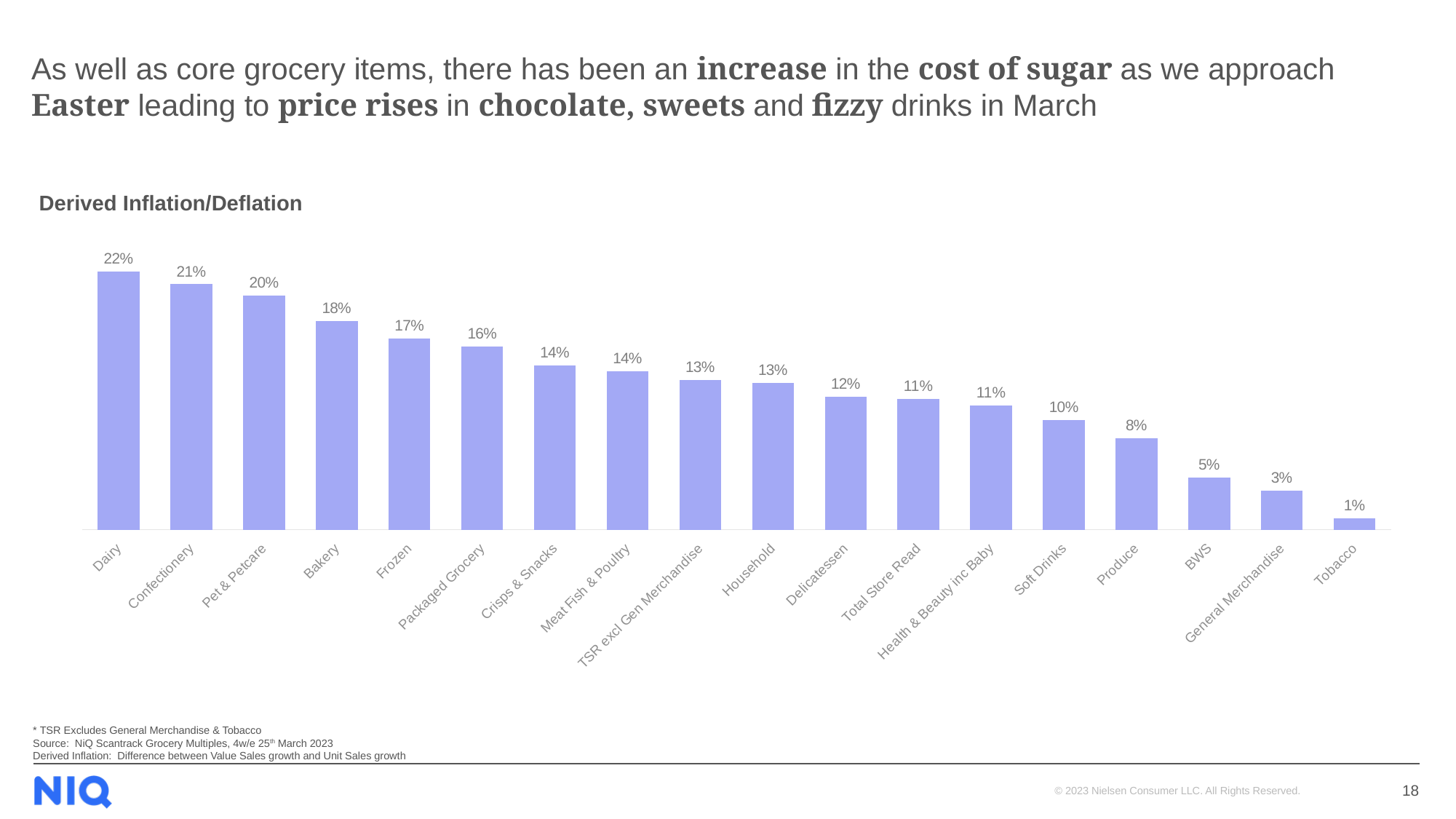
What is the difference between the derived inflation for Dairy and for Produce? 14% Which category has the lowest derived inflation? Tobacco Which category has the highest derived inflation? Dairy What is the derived inflation value for Confectionery? 21% What type of chart is shown on the slide? Bar chart How many categories are shown in the chart? 18 What is the derived inflation value for Tobacco? 1% What is the title of the chart? Derived Inflation/Deflation Which has a higher derived inflation, Pet & Petcare or Frozen? Pet & Petcare What is the derived inflation value for Soft Drinks? 10% What is the derived inflation value for Dairy? 22% What is the difference between the derived inflation for Bakery and for BWS? 13%